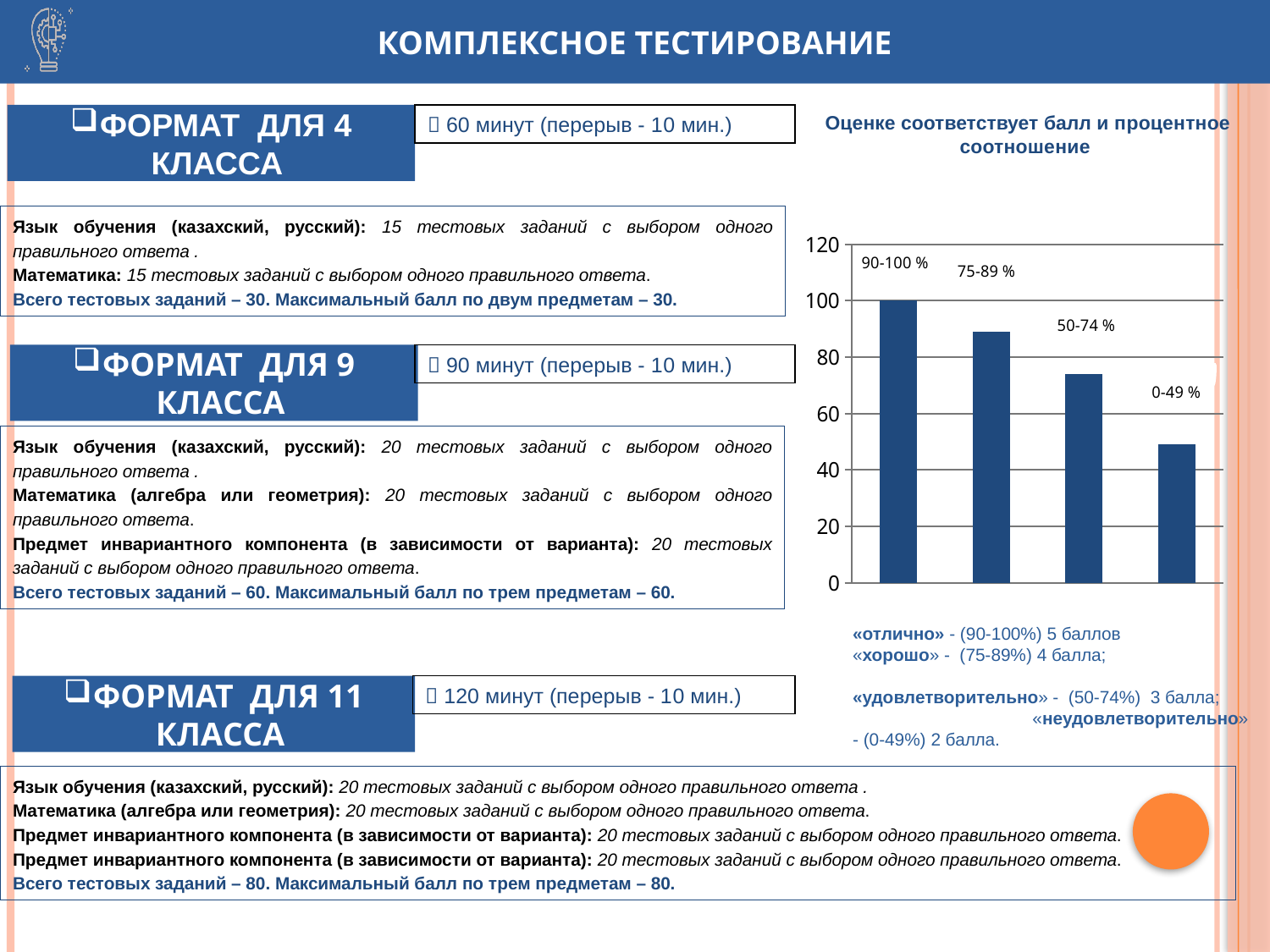
Which category has the highest bar in the chart? 90-100 % Is the value for 75-89 % greater or less than 80? greater Is the value for 50-74 % greater or less than 80? less What kind of chart is shown on the slide? bar chart What value does the bar for 90-100 % reach on the vertical axis? 100 What is the title shown above the chart? Оценке соответствует балл и процентное соотношение Is the value for 0-49 % greater or less than 40? greater Which bar is taller: 75-89 % or 50-74 %? 75-89 % How many bars does the chart contain? 4 Do the bar values rise or fall from left to right along the x axis? fall Which category has the lowest bar in the chart? 0-49 %